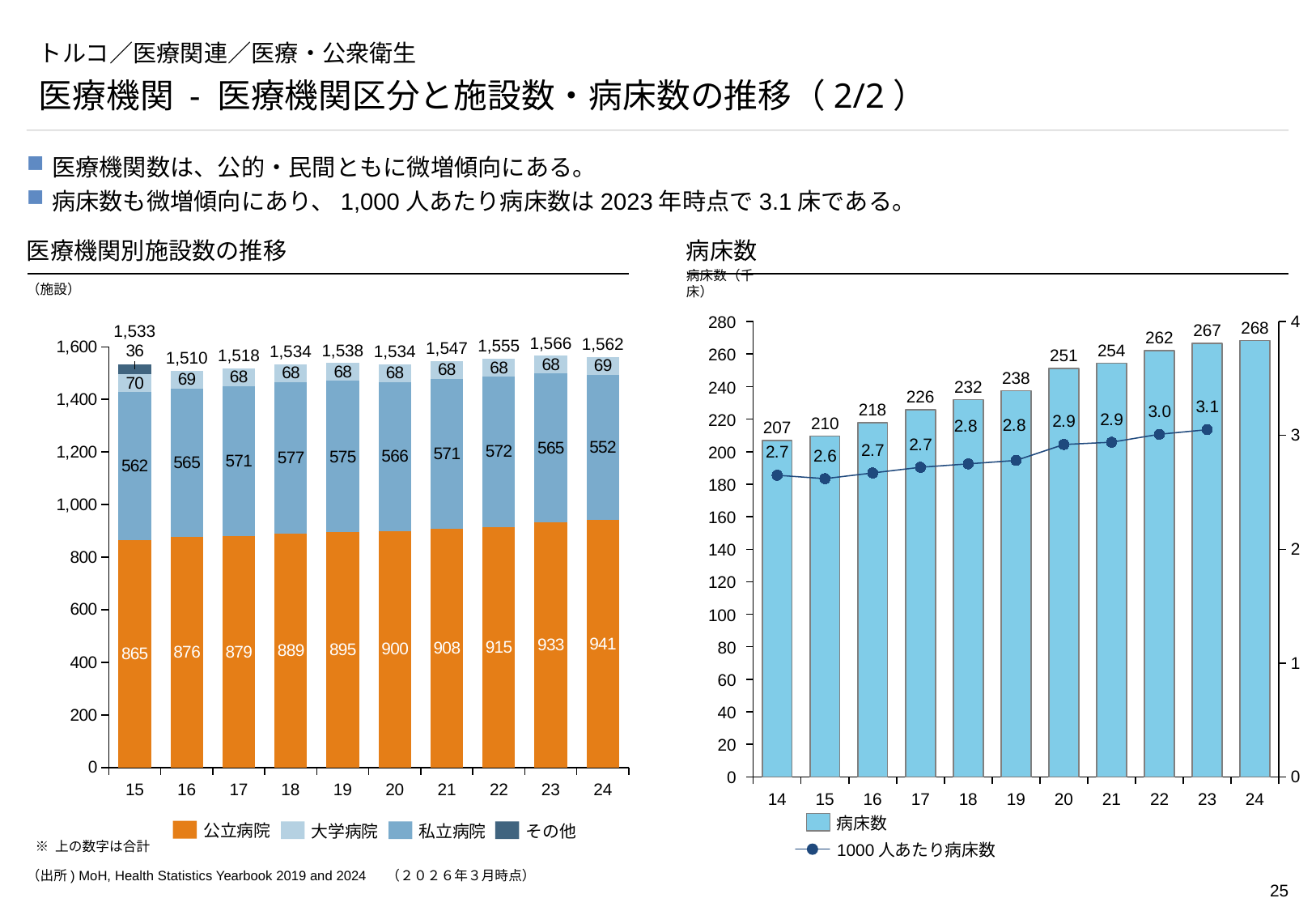
In the 病床数 chart, what is the 病床数 value for 24? 268 In the 病床数 chart, how many years are shown on the x axis? 11 In the 医療機関別施設数の推移 chart, how many series does the legend list? 4 In the 医療機関別施設数の推移 chart, what is the value for 私立病院 in 18? 577 In the 医療機関別施設数の推移 chart, what is the total of the stacked bar for 15? 1,533 In the 医療機関別施設数の推移 chart, which year has the highest total? 23 In the 医療機関別施設数の推移 chart, what is the value for 公立病院 in 24? 941 In the 医療機関別施設数の推移 chart, what is the difference between the 公立病院 values for 24 and 15? 76 In the 病床数 chart, which year has the lowest 病床数? 14 In the 病床数 chart, do the 病床数 values generally rise or fall from 14 to 24? rise In the 病床数 chart, what is the difference in 病床数 between 24 and 14? 61 In the 病床数 chart, what is the 1000人あたり病床数 value for 23? 3.1